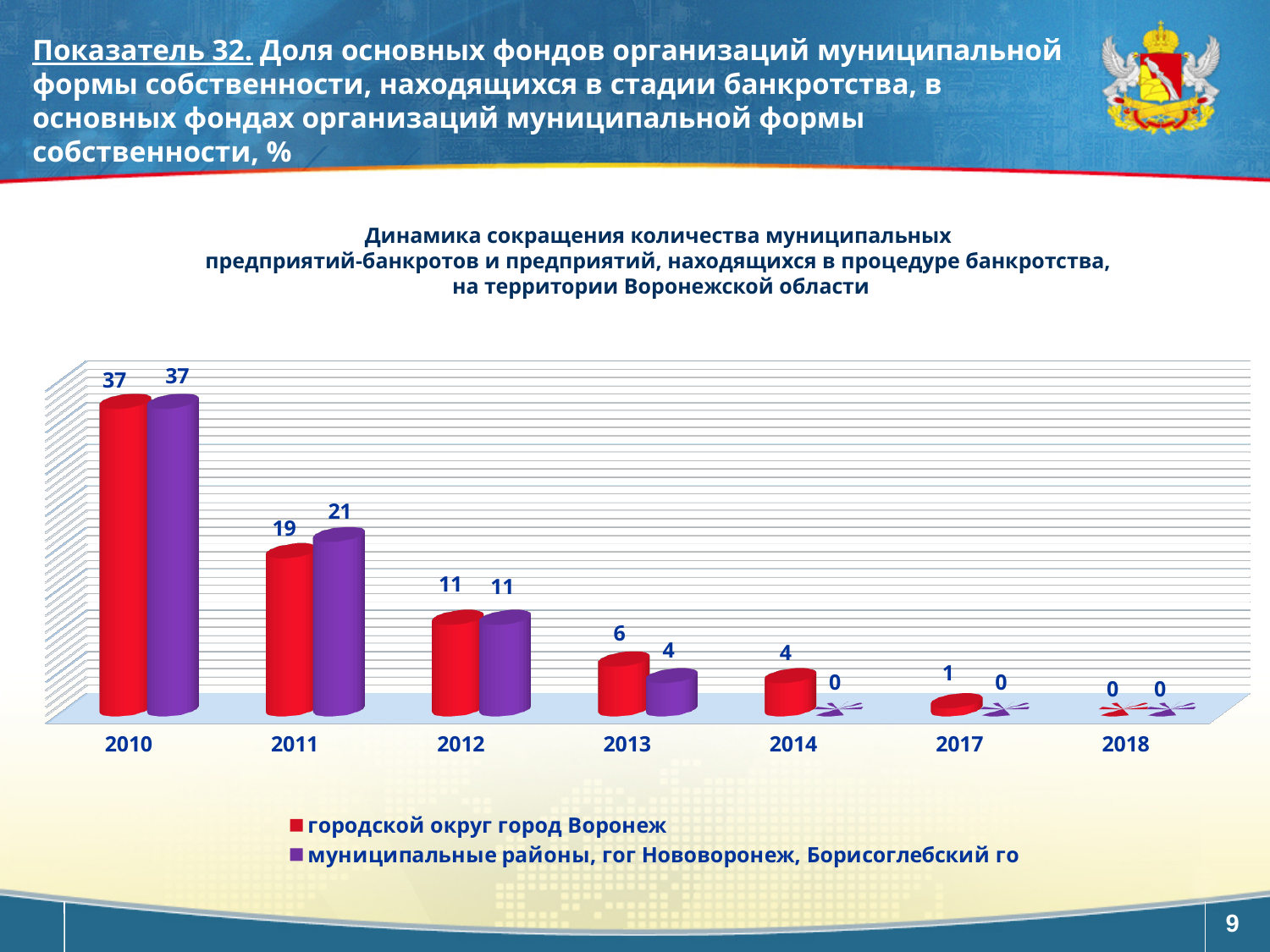
Каким цветом на диаграмме показана серия «городской округ город Воронеж»? красным На сколько значение серии «муниципальные районы, гог Нововоронеж, Борисоглебский го» в 2011 году больше значения серии «городской округ город Воронеж» в том же году? 2 В каком году значение серии «городской округ город Воронеж» наибольшее? 2010 Сколько лет (категорий) показано на оси x диаграммы? 7 Сколько серий перечислено в легенде диаграммы? 2 Как изменяются значения серии «городской округ город Воронеж» с 2010 по 2018 год — растут или падают? падают На сколько значение серии «городской округ город Воронеж» в 2010 году больше, чем в 2012 году? 26 Какого типа эта диаграмма? столбчатая (bar chart) Какое значение у серии «муниципальные районы, гог Нововоронеж, Борисоглебский го» в 2011 году? 21 Какое значение у серии «городской округ город Воронеж» в 2010 году? 37 Какое значение у серии «городской округ город Воронеж» в 2014 году? 4 Какая серия имеет большее значение в 2013 году: «городской округ город Воронеж» или «муниципальные районы, гог Нововоронеж, Борисоглебский го»? городской округ город Воронеж